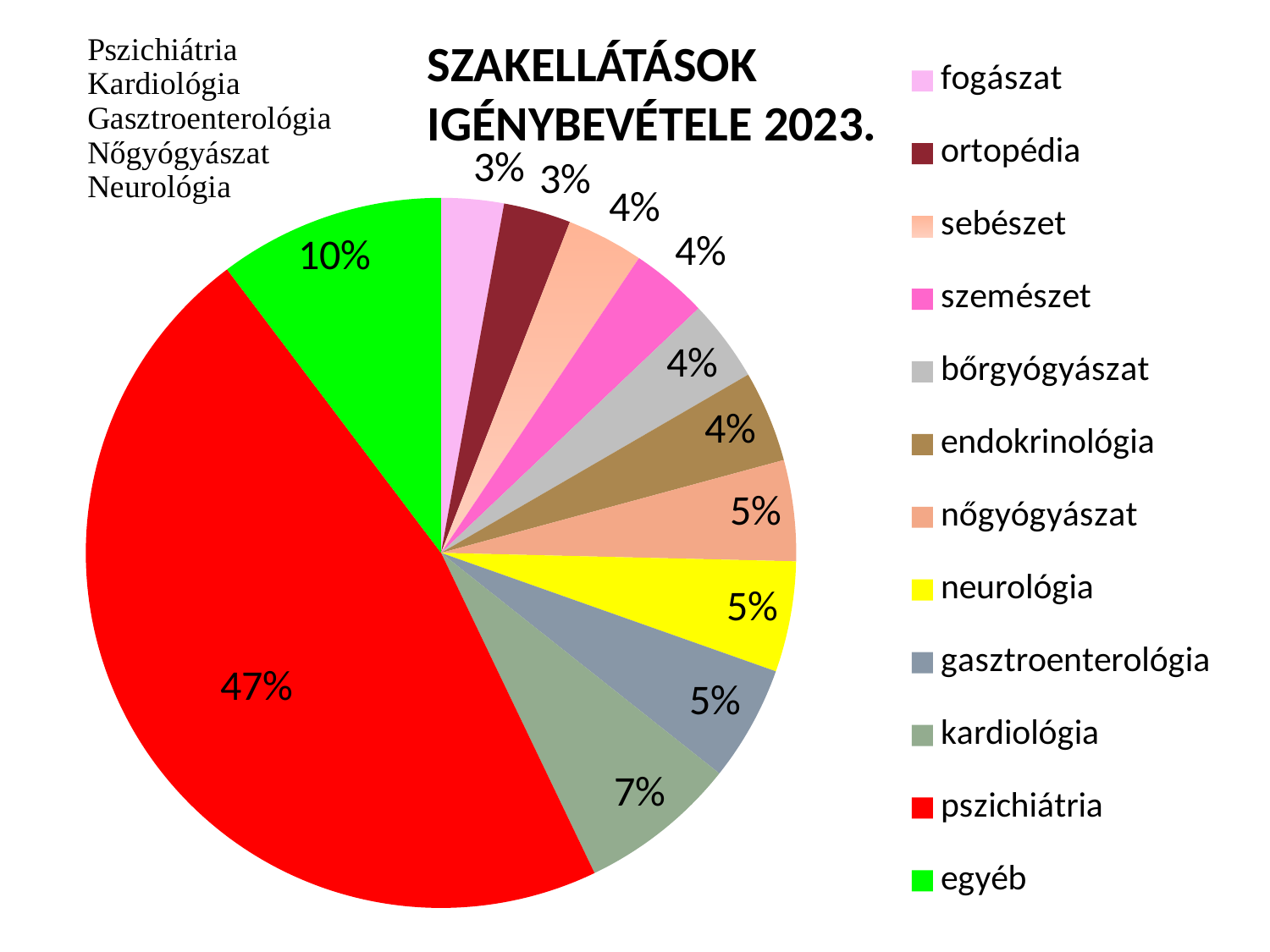
What colour is the slice for pszichiátria? red Which is larger, the share for kardiológia or the share for gasztroenterológia? kardiológia What type of chart is shown on the slide? pie chart What is the value shown for neurológia? 5% What is the difference between the shares of pszichiátria and egyéb? 37% What share of the pie does pszichiátria have? 47% How many slices does the pie chart have? 12 What is the title of the chart? SZAKELLÁTÁSOK IGÉNYBEVÉTELE 2023. Which category has the largest slice of the pie? pszichiátria How many entries does the legend list? 12 What is the value shown for egyéb? 10% What is the value shown for kardiológia? 7%